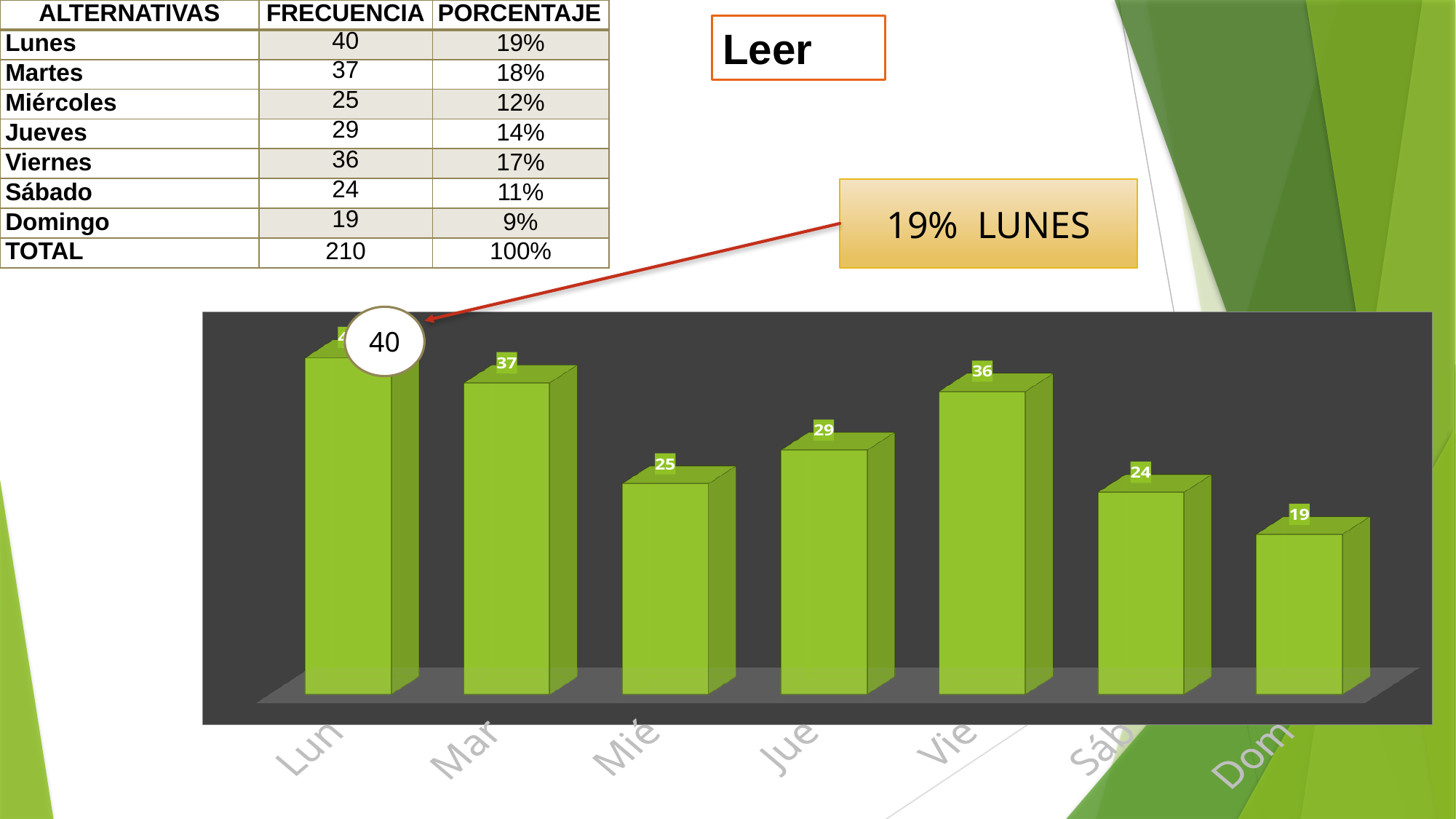
What is the value of the bar for Jue? 29 What value is shown in the circle callout above the Lun bar? 40 What is the difference between the values for Sáb and Dom? 5 What is the value of the bar for Vie? 36 Which category has the lowest bar? Dom Which category has the highest bar? Lun How many categories are shown on the x axis of the chart? 7 What is the difference between the values for Mar and Mié? 12 Which is larger, the value for Jue or the value for Sáb? Jue What is the value of the bar for Mar? 37 What kind of chart is shown on the slide? bar chart What is the value of the bar for Dom? 19